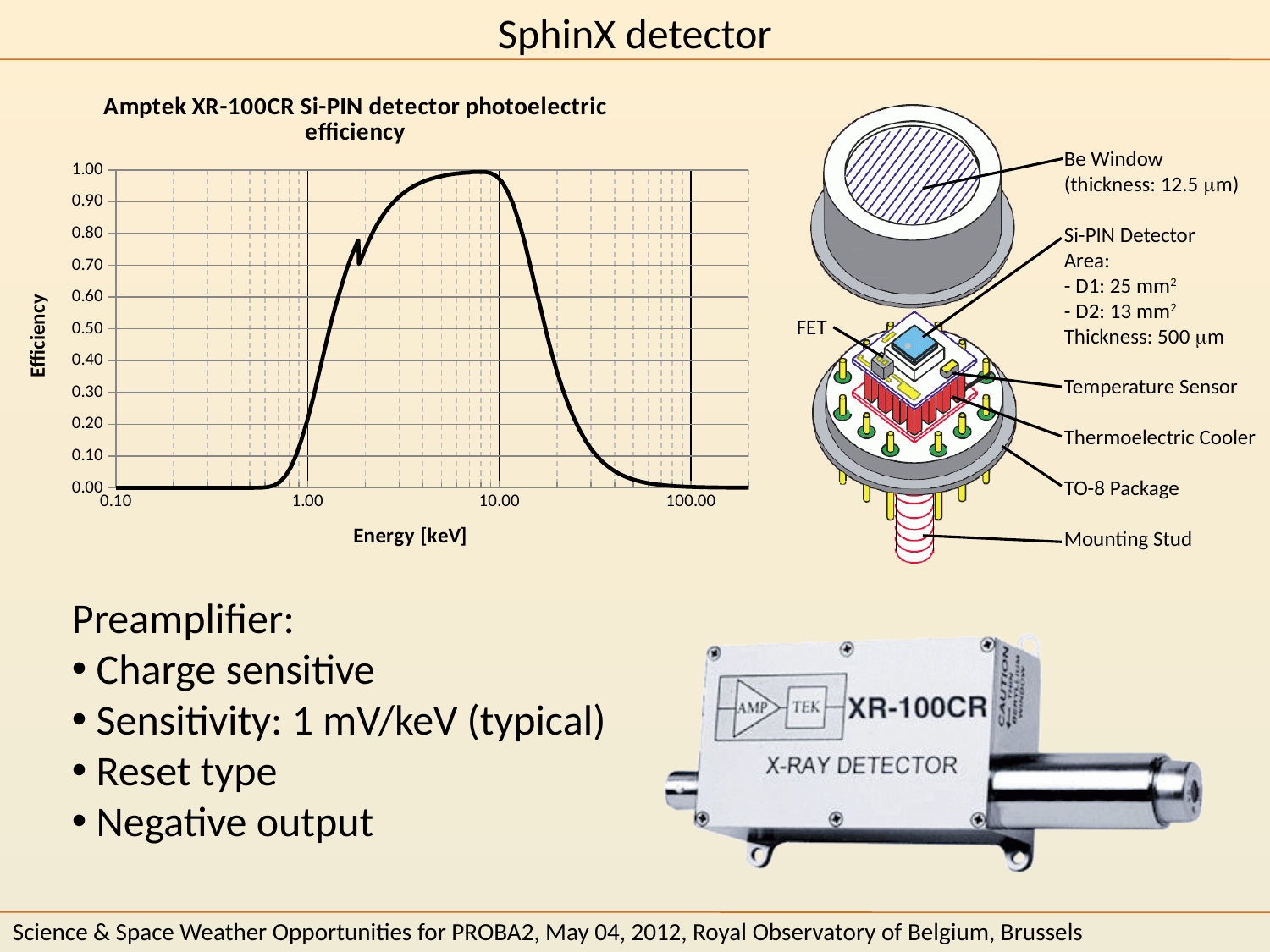
What is the title of the chart? Amptek XR-100CR Si-PIN detector photoelectric efficiency Which of the labeled energy ticks, 10.00 keV or 100.00 keV, has the lower efficiency? 100.00 keV Is the efficiency at 1.00 keV greater or less than 0.50? less Is the efficiency at 100.00 keV greater or less than 0.10? less How many energy tick labels are shown on the x axis of the chart? 4 What is the label of the x axis of the chart? Energy [keV] Which of the labeled energy ticks, 1.00 keV or 10.00 keV, has the higher efficiency? 10.00 keV What kind of chart is shown on the slide? line chart Does the efficiency rise or fall as energy increases from 1.00 keV to 10.00 keV? rise Is the efficiency at 10.00 keV greater or less than 0.90? greater Does the efficiency rise or fall as energy increases from 10.00 keV to 100.00 keV? fall